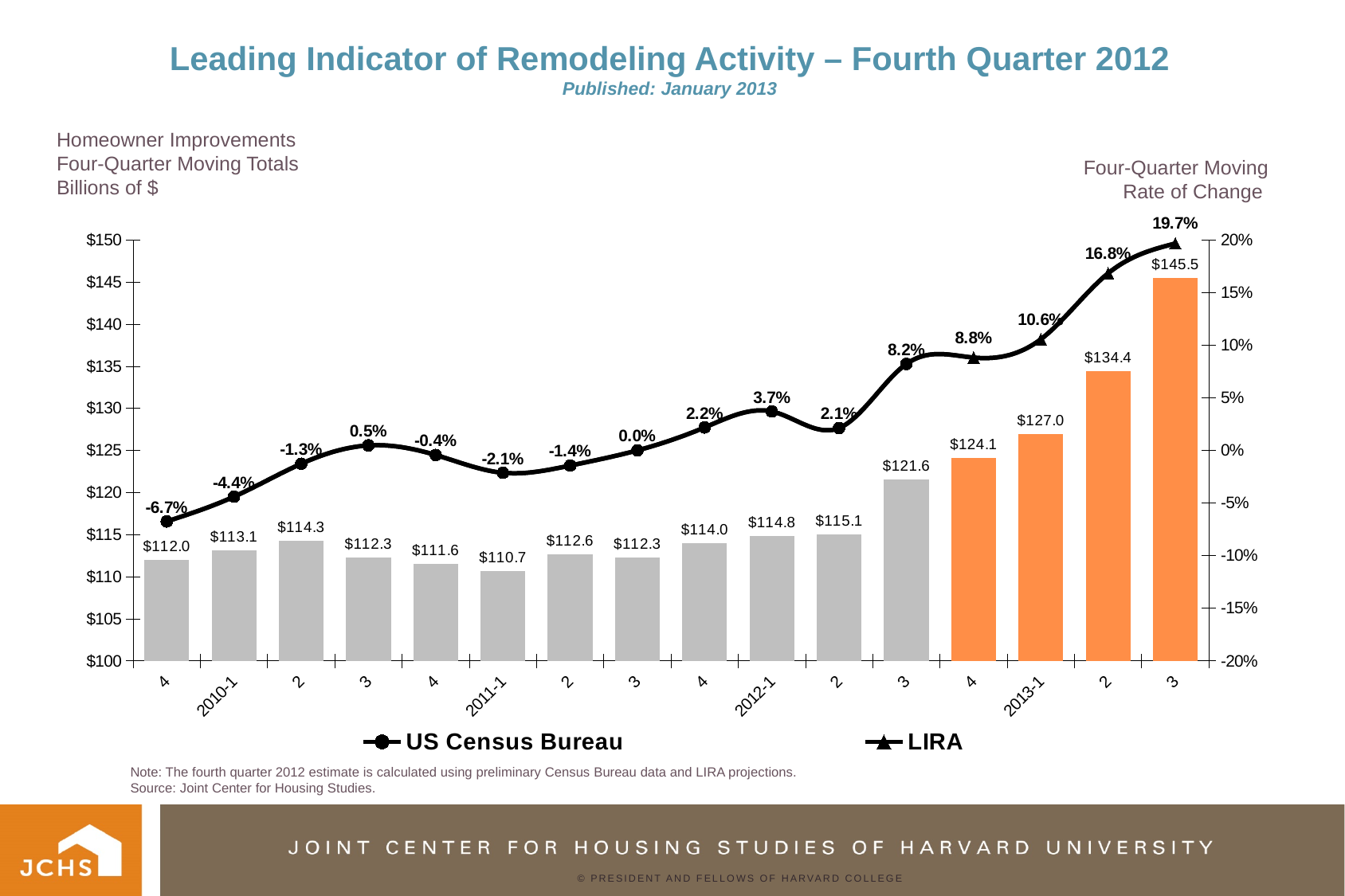
What is the highest four-quarter moving rate of change shown on the chart? 19.7% Which quarter has the lowest four-quarter moving total? 2011-1 Do the four-quarter moving totals rise or fall from 2012-2 to 2013-3? Rise How many quarters (bars) are plotted on the chart? 16 What is the difference between the four-quarter moving totals for 2013-3 and 2013-2? $11.1 Which quarter has the highest four-quarter moving total? 2013-3 How many series does the legend list? 2 What is the four-quarter moving total for the third quarter of 2012? $121.6 Which is larger, the four-quarter moving total for 2010-2 or for 2011-4? 2010-2 What is the four-quarter moving rate of change shown for 2013-1? 10.6% What is the four-quarter moving total for 2012-1? $114.8 What kind of chart is this? Combination bar and line chart